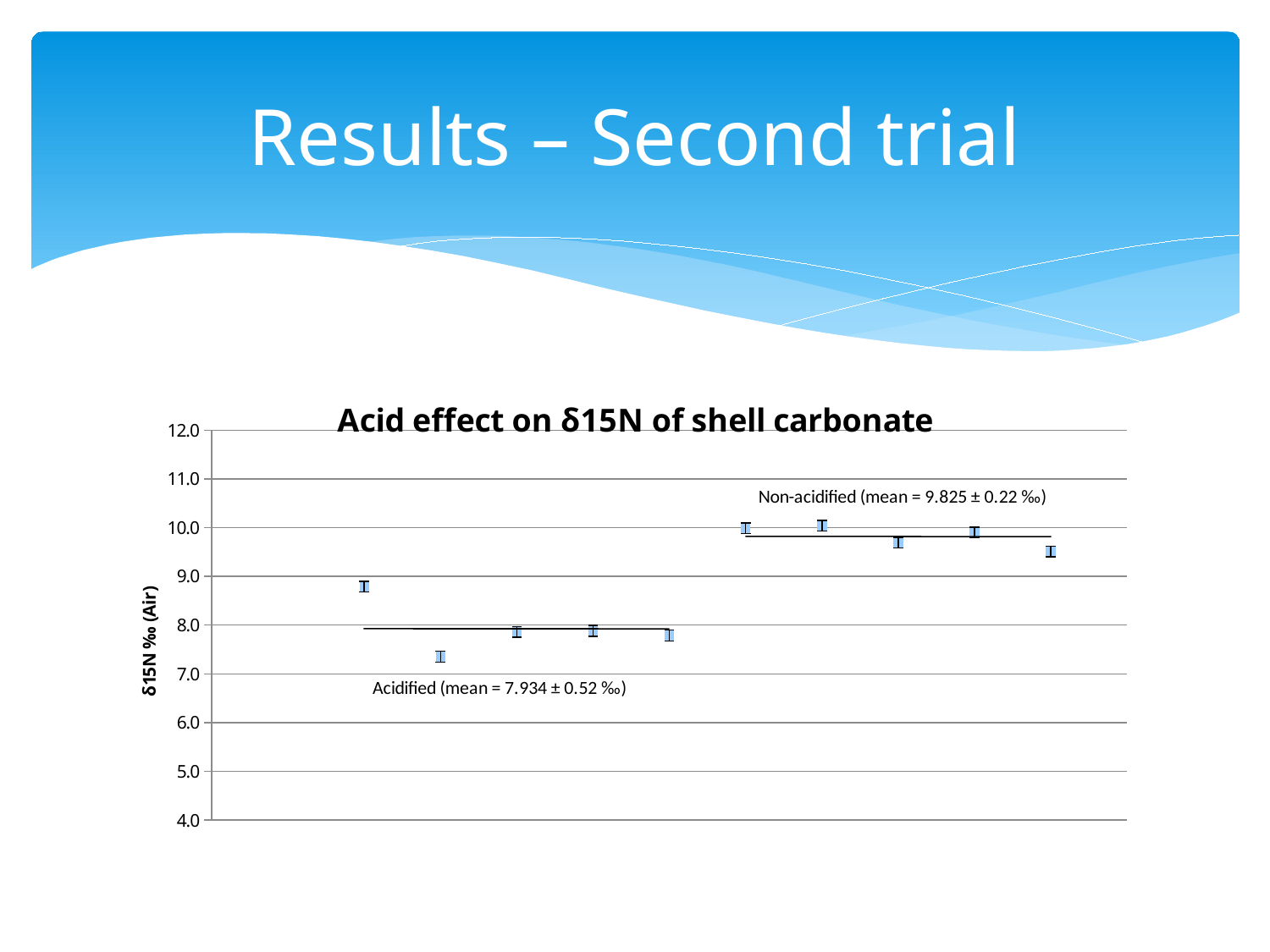
Are all the Non-acidified data points greater or less than 9.0 on the δ15N axis? greater What is the difference between the Non-acidified mean (9.825 ‰) and the Acidified mean (7.934 ‰)? 1.891 ‰ What kind of chart is shown on the slide? Scatter chart with error bars What is the label on the vertical axis of the chart? δ15N ‰ (Air) Is the lowest Acidified data point greater or less than 8.0 on the δ15N axis? less Which group has the higher mean δ15N, Acidified or Non-acidified? Non-acidified What is the mean δ15N value given for the Non-acidified group? 9.825 ± 0.22 ‰ How many sample groups are shown on the chart? 2 How many data points are plotted for the Acidified group? 5 What is the title of the chart? Acid effect on δ15N of shell carbonate How many data points are plotted for the Non-acidified group? 5 What is the mean δ15N value given for the Acidified group? 7.934 ± 0.52 ‰